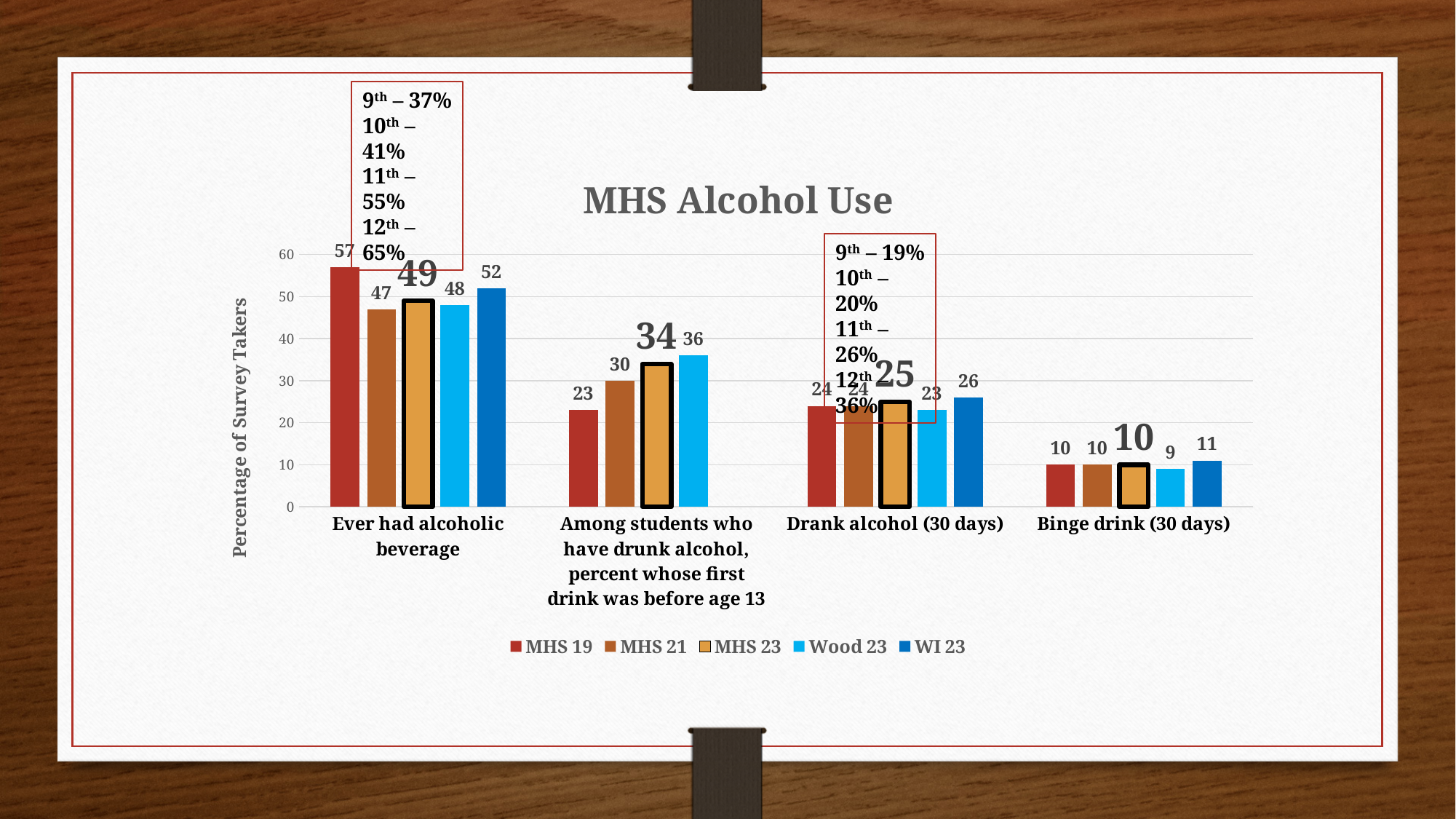
What is the label of the vertical axis? Percentage of Survey Takers What is the difference between the MHS 19 and MHS 21 values in the 'Ever had alcoholic beverage' category? 10 What is the value for Wood 23 in the 'Binge drink (30 days)' category? 9 How many series does the legend list? 5 What is the chart's title? MHS Alcohol Use How many categories are shown on the x axis? 4 In the 'Drank alcohol (30 days)' category, which is larger: WI 23 or Wood 23? WI 23 What is the value for MHS 23 in the 'Drank alcohol (30 days)' category? 25 Which series has the highest value in the 'Ever had alcoholic beverage' category? MHS 19 What type of chart is shown on the slide? bar chart What is the value for MHS 19 in the 'Ever had alcoholic beverage' category? 57 Which series has the lowest value in the 'Among students who have drunk alcohol, percent whose first drink was before age 13' category? MHS 19